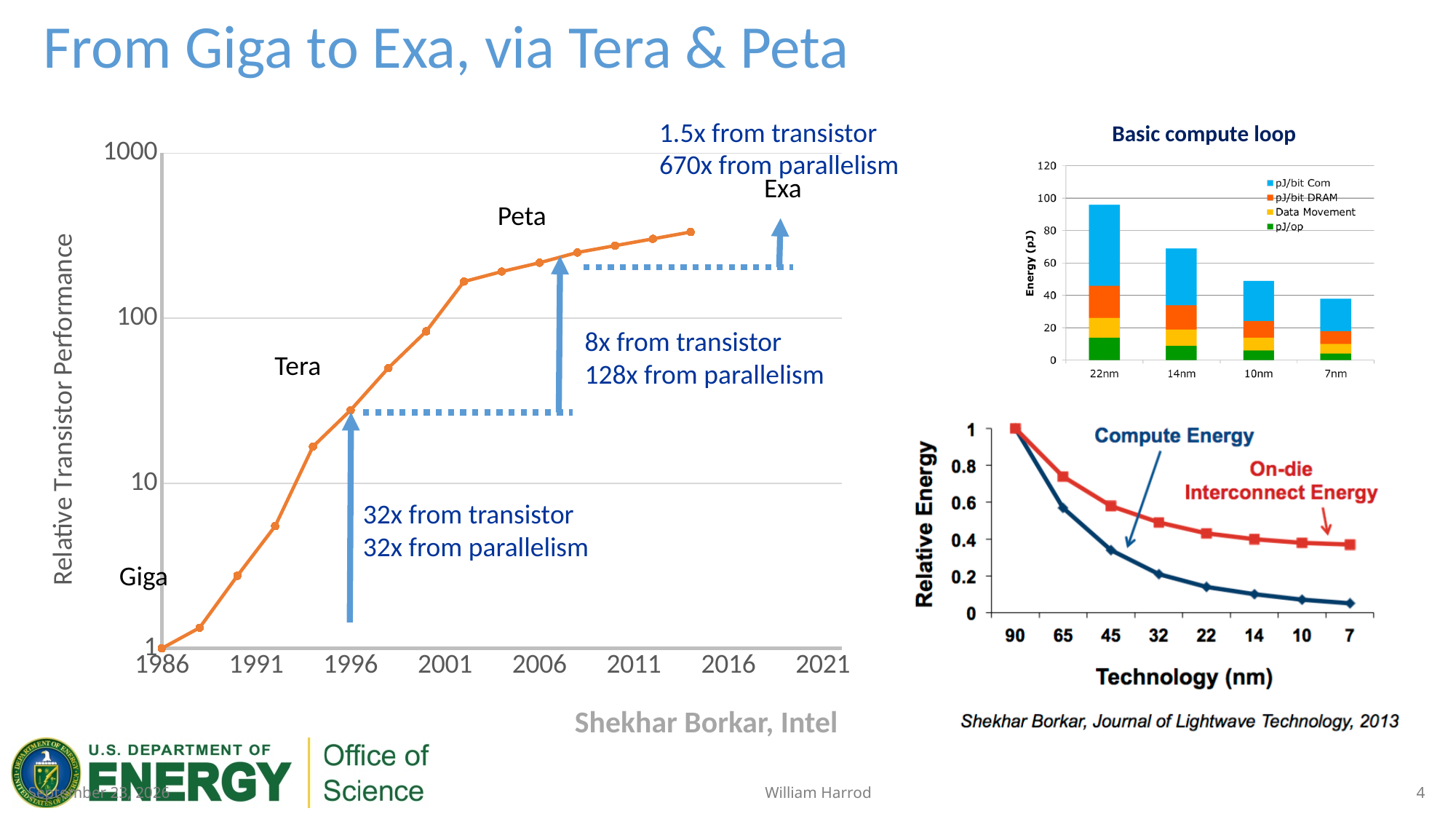
In the 'Relative Energy' chart at the bottom right, which is larger at 7 nm: Compute Energy or On-die Interconnect Energy? On-die Interconnect Energy In the 'Basic compute loop' chart, how many series does the legend list? 4 What is the y-axis label of the large chart on the left? Relative Transistor Performance In the large chart on the left, is the value for 2006 greater or less than 100? greater In the 'Basic compute loop' chart, which technology node has the highest total energy? 22nm In the large chart on the left, do the values rise or fall from 1986 to 2016? rise In the 'Relative Energy' chart at the bottom right, how many series are plotted? 2 In the 'Basic compute loop' chart, is the total for 22nm greater or less than 80? greater In the 'Relative Energy' chart at the bottom right, is the Compute Energy value at 45 nm greater or less than 0.4? less In the 'Basic compute loop' chart, how many technology nodes are shown on the x axis? 4 What kind of chart is the large chart on the left of the slide? line chart